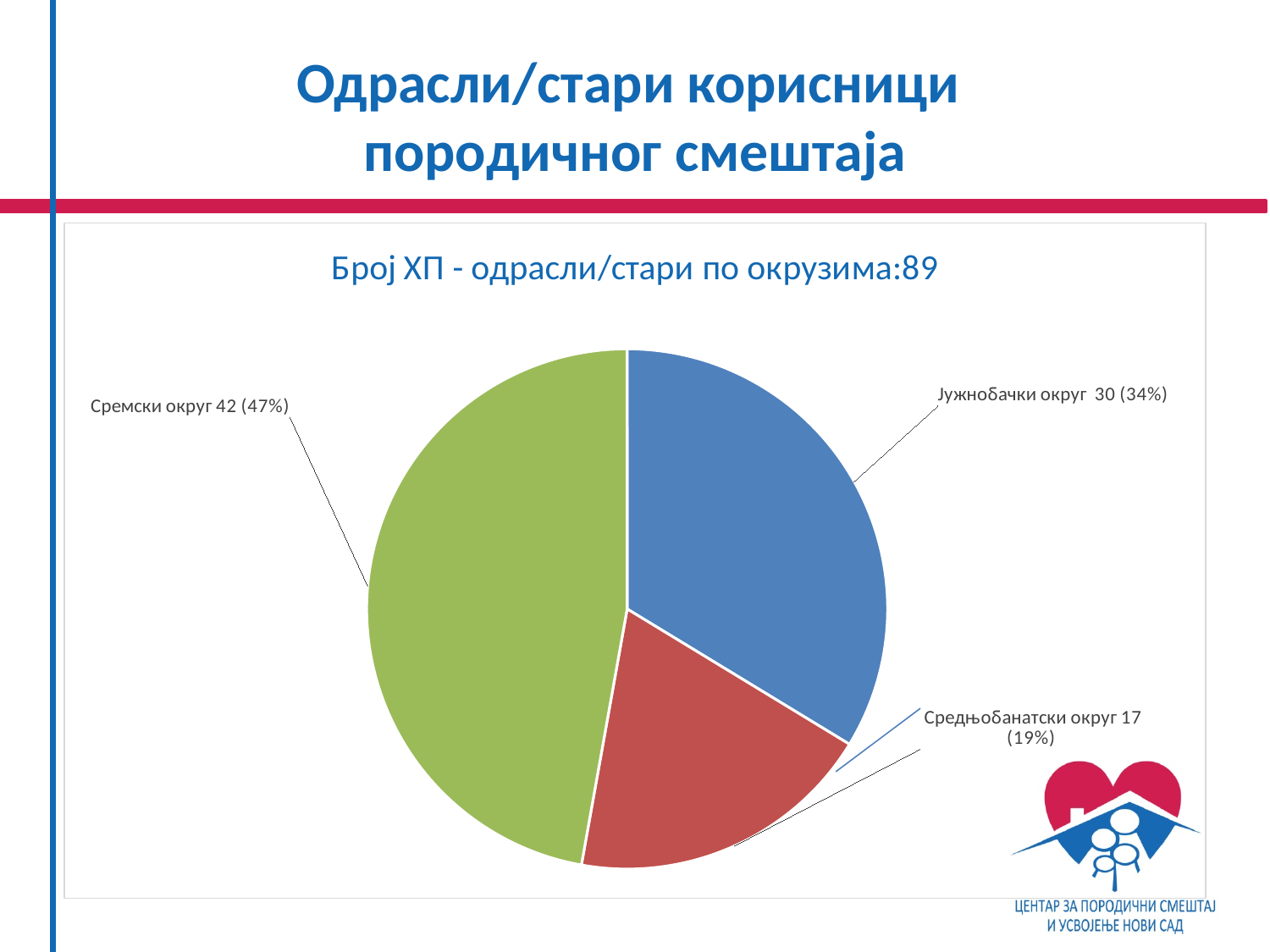
What share of the pie does Јужнобачки округ represent? 34% How many slices does the pie chart have? 3 Which district has the smallest slice? Средњобанатски округ Which district has the largest slice? Сремски округ What kind of chart is shown on the slide? pie chart What is the value for Средњобанатски округ? 17 What is the value for Јужнобачки округ? 30 What is the title of the chart? Број ХП - одрасли/стари по окрузима:89 What is the difference between the values for Сремски округ and Јужнобачки округ? 12 Which is larger, the value for Јужнобачки округ or Средњобанатски округ? Јужнобачки округ What share of the pie does Средњобанатски округ represent? 19% What is the value for Сремски округ? 42